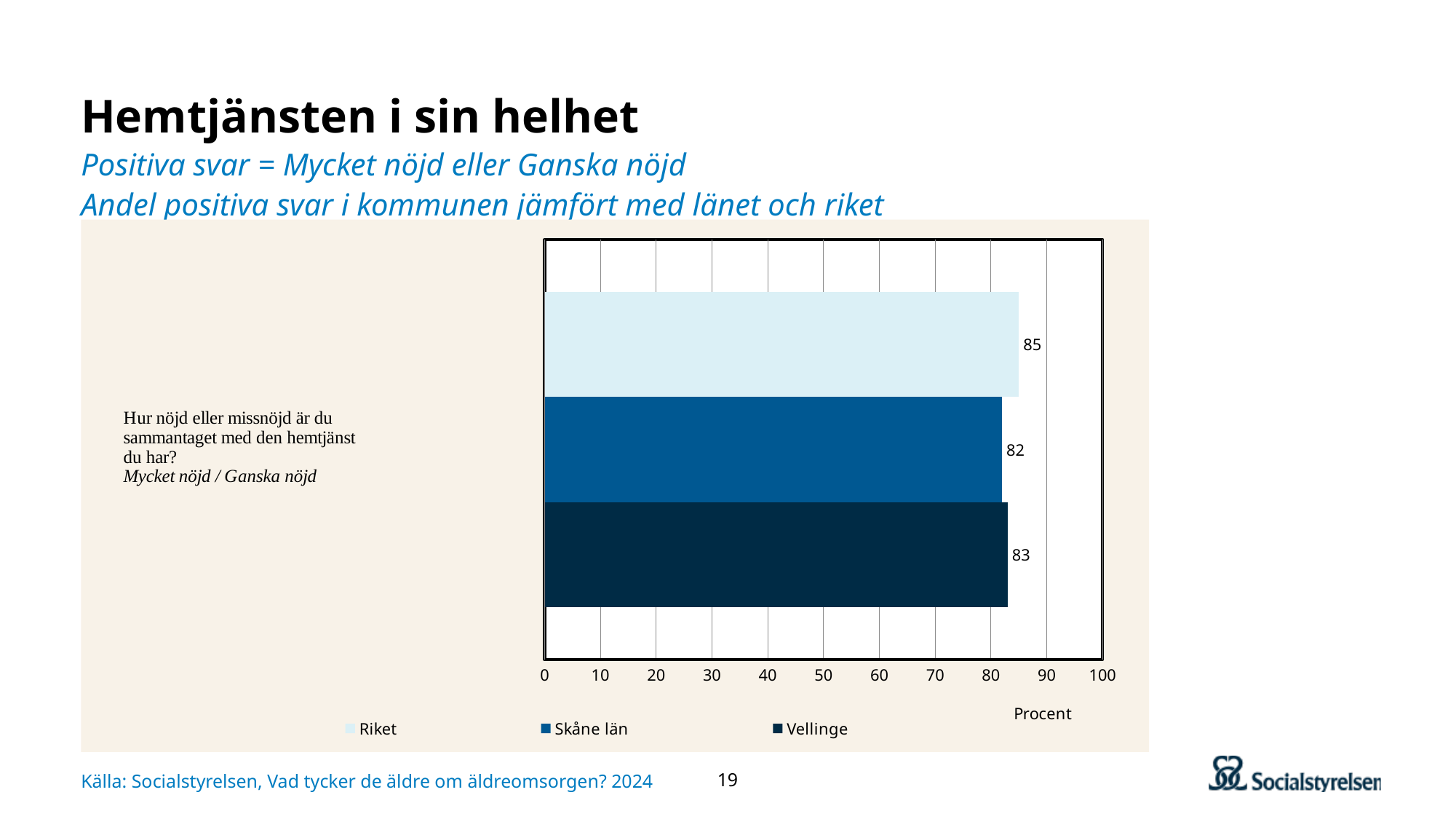
Is the value for Vellinge greater or less than 90? less What is the value for Skåne län? 82 How many series does the legend list? 3 Which series has the lowest value? Skåne län What is the value for Vellinge? 83 What is the difference between the values for Riket and Skåne län? 3 What unit is shown on the horizontal axis of the chart? Procent What kind of chart is shown on the slide? bar chart What is the difference between the values for Vellinge and Skåne län? 1 What is the value for Riket? 85 Which series has the highest value? Riket Which is larger, the value for Riket or the value for Vellinge? Riket